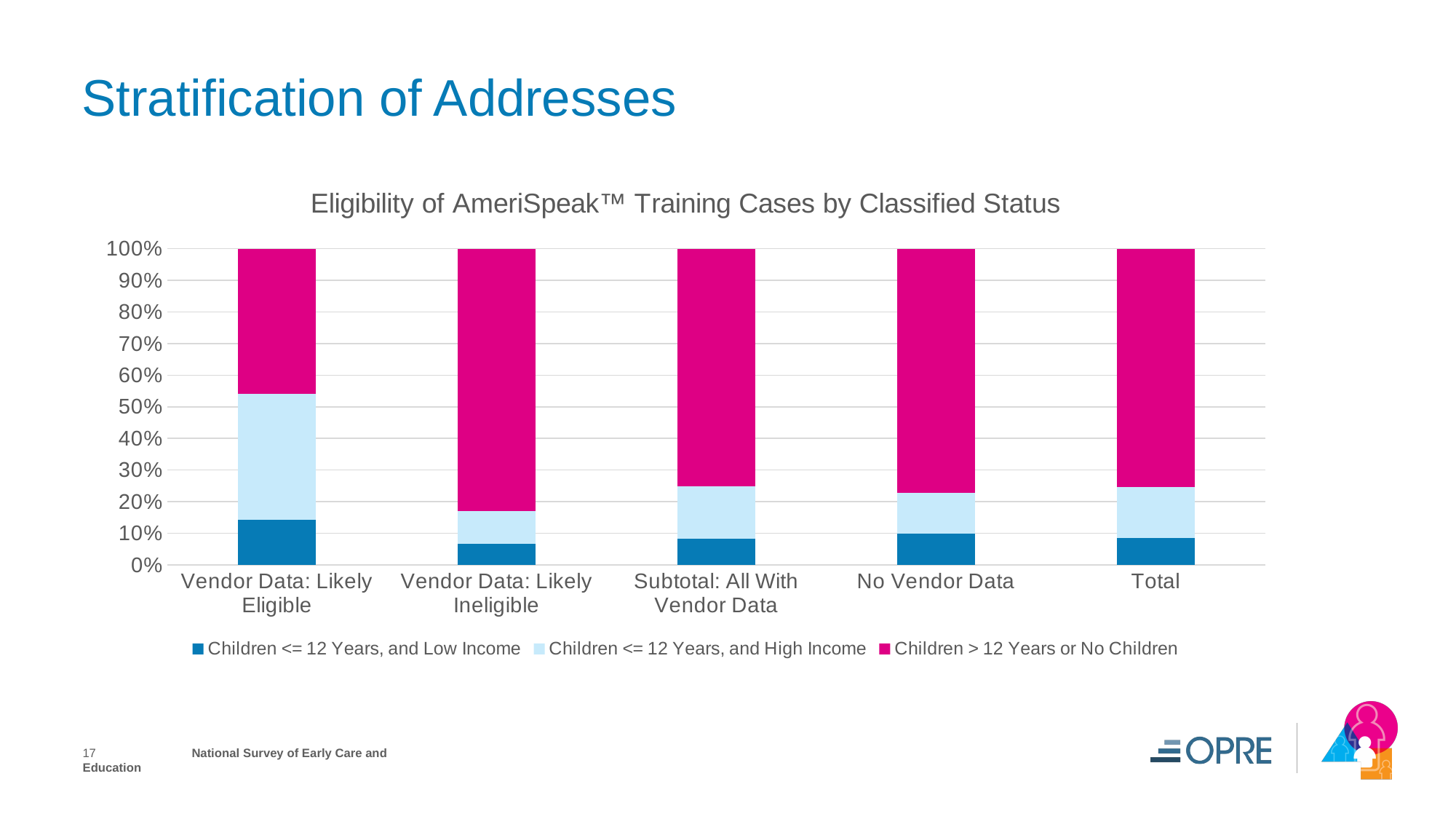
What does each stacked bar in the chart total? 100% Is the 'Children <= 12 Years, and Low Income' value for Vendor Data: Likely Ineligible greater or less than 10%? less Which is larger, the 'Children <= 12 Years, and Low Income' segment for Vendor Data: Likely Eligible or for Vendor Data: Likely Ineligible? Vendor Data: Likely Eligible Which category has the largest 'Children <= 12 Years, and Low Income' segment? Vendor Data: Likely Eligible Which category has the smallest share of 'Children > 12 Years or No Children'? Vendor Data: Likely Eligible How many series does the chart's legend list? 3 What kind of chart is shown on the slide? Stacked bar chart Is the 'Children <= 12 Years, and Low Income' value for Vendor Data: Likely Eligible greater or less than 10%? greater Which category has the largest share of 'Children > 12 Years or No Children'? Vendor Data: Likely Ineligible How many categories are shown along the x axis of the chart? 5 In the Vendor Data: Likely Eligible bar, is the combined share of the two 'Children <= 12 Years' segments greater or less than 50%? greater What is the title of the chart? Eligibility of AmeriSpeak™ Training Cases by Classified Status